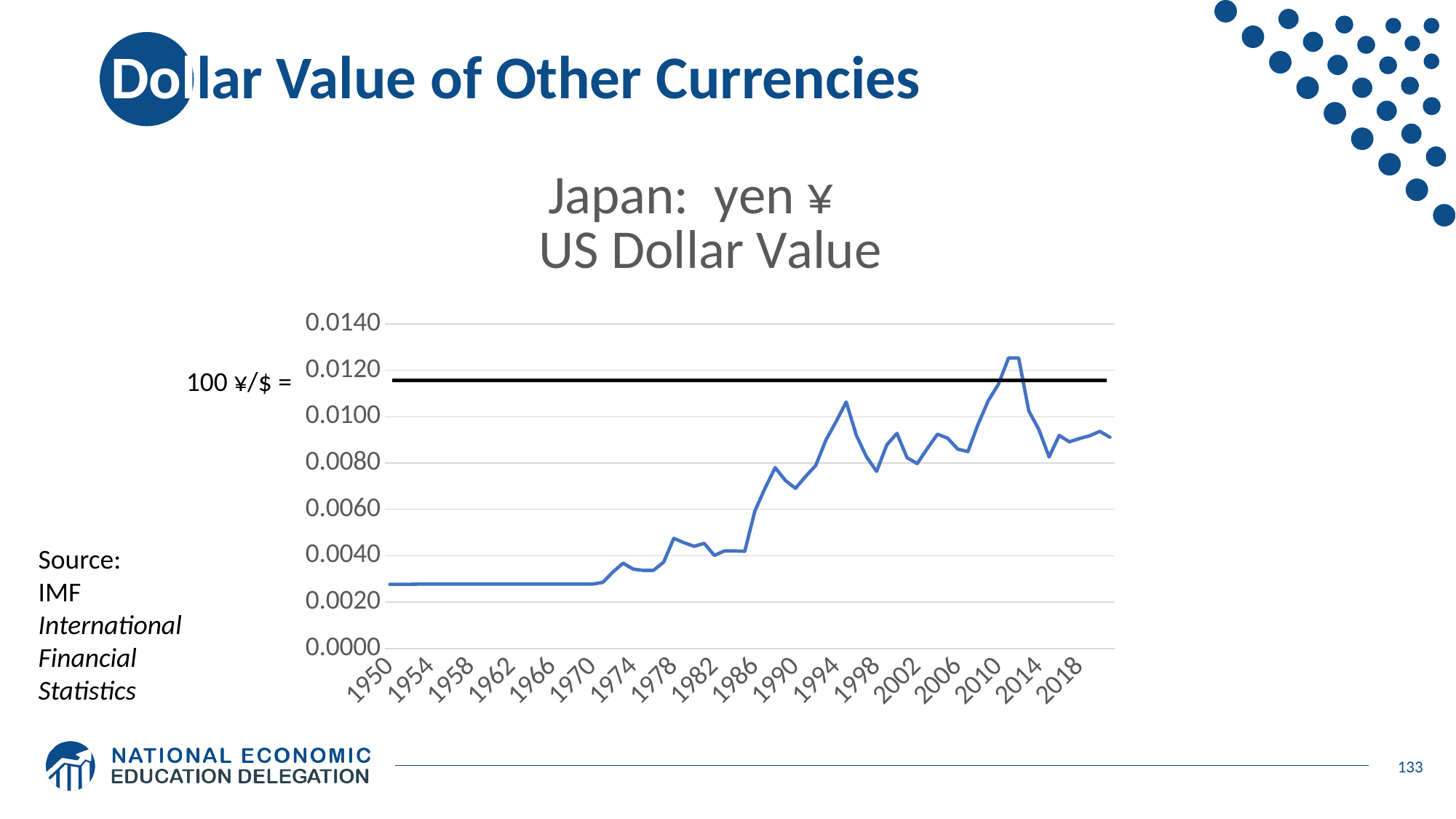
What is the title of the chart? Japan: yen ¥ US Dollar Value Is the peak value reached in the early 2010s greater or less than 0.0120? greater Which is larger, the value for 1950 or the value for 2018? 2018 What label is attached to the horizontal black reference line on the chart? 100 ¥/$ = How many year labels are shown on the x axis? 18 Is the value for 1970 greater or less than 0.0040? less Is the value for 1950 greater or less than 0.0040? less What kind of chart is shown on the slide? line chart Overall, does the US dollar value of the yen rise or fall from 1950 to 2018? rise In which decade does the line reach its highest value? 2010s